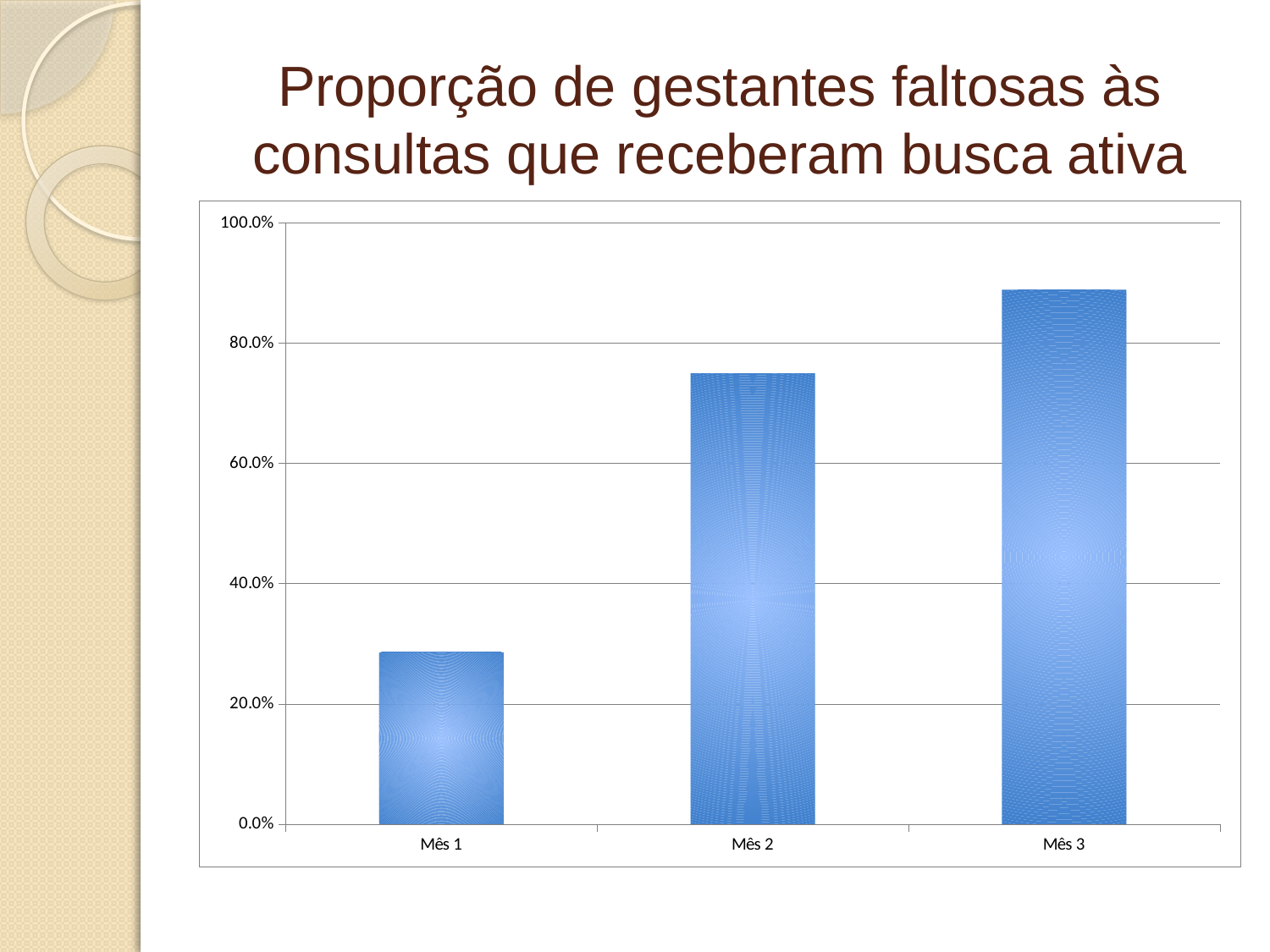
Which is larger, the value for Mês 1 or the value for Mês 2? Mês 2 Is the value for Mês 1 greater or less than 40.0%? less Which month has the lowest proportion? Mês 1 What is the title of the slide? Proporção de gestantes faltosas às consultas que receberam busca ativa Is the value for Mês 2 greater or less than 80.0%? less Do the values rise or fall from Mês 1 to Mês 3? rise What is the maximum value shown on the y axis? 100.0% Is the value for Mês 2 greater or less than 60.0%? greater What kind of chart is shown on the slide? bar chart Which month has the highest proportion? Mês 3 How many categories are plotted on the x axis? 3